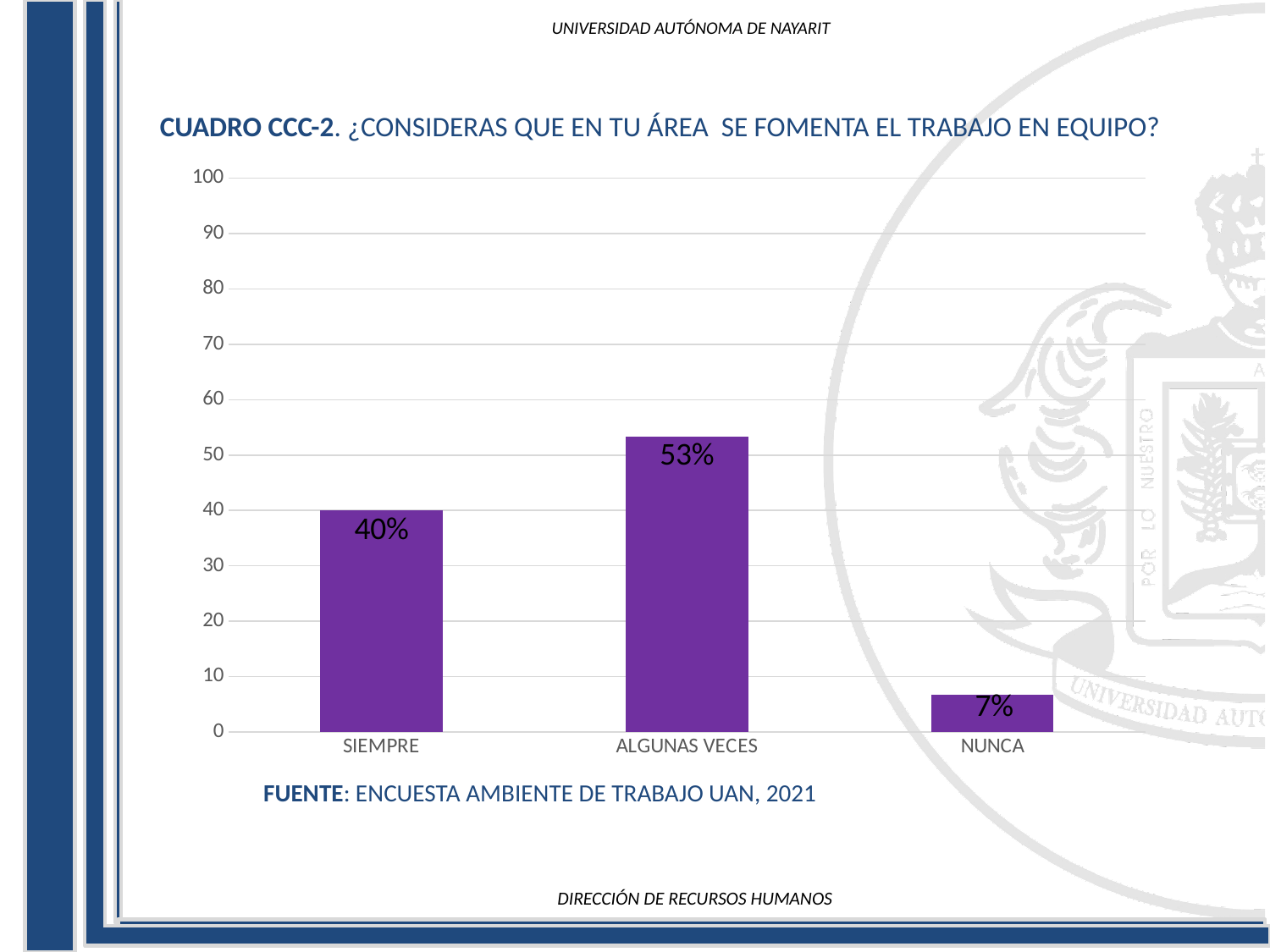
Which is larger, the value for SIEMPRE or the value for NUNCA? SIEMPRE Is the value for ALGUNAS VECES greater or less than 50? greater How many categories are shown on the x axis? 3 What is the value for ALGUNAS VECES? 53% What source is cited below the chart? ENCUESTA AMBIENTE DE TRABAJO UAN, 2021 What is the value for NUNCA? 7% What is the difference between the values for SIEMPRE and NUNCA? 33% Which category has the lowest value? NUNCA What is the difference between the values for ALGUNAS VECES and SIEMPRE? 13% What kind of chart is shown on the slide? bar chart What is the value for SIEMPRE? 40% Which category has the highest value? ALGUNAS VECES